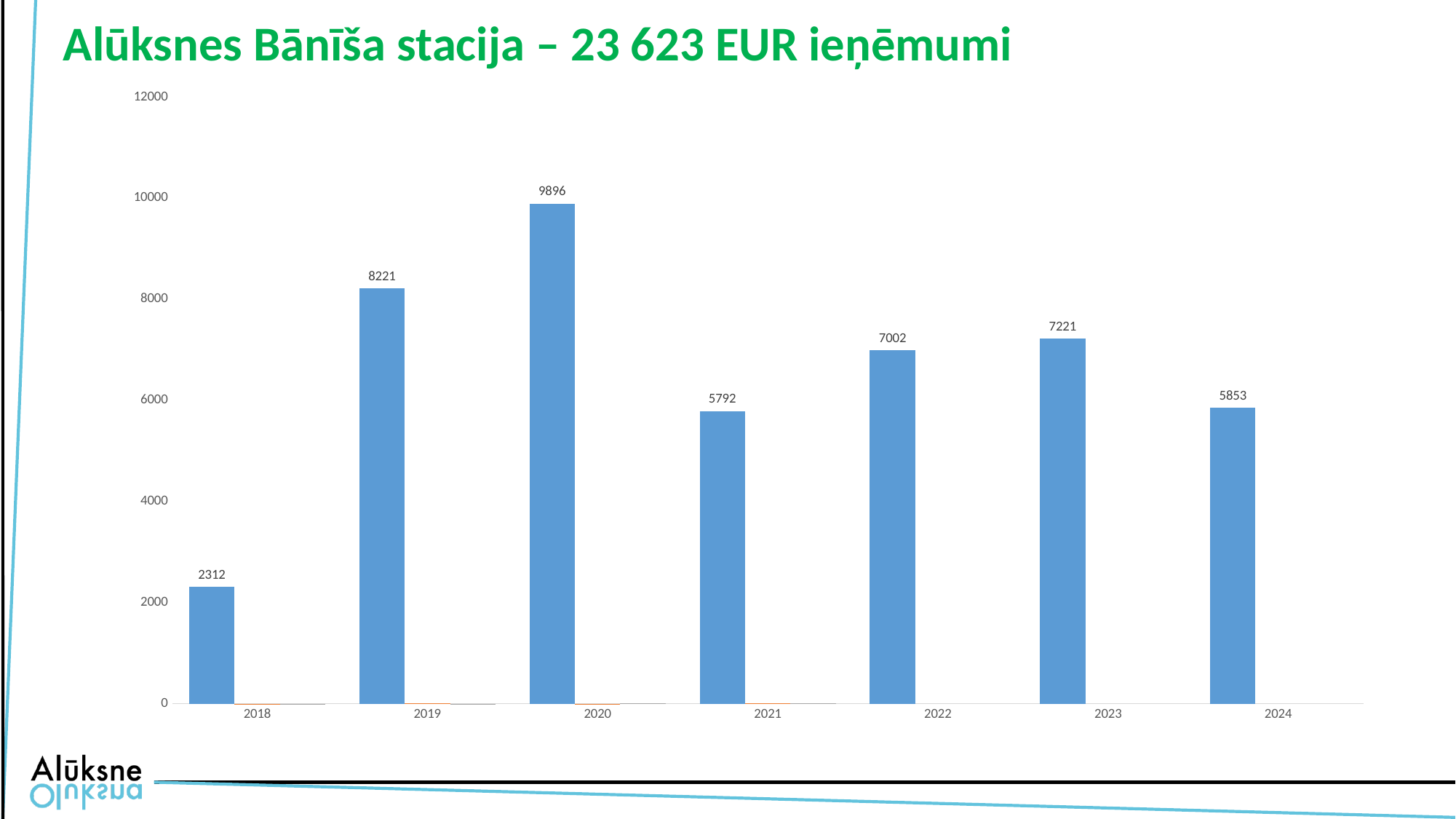
What kind of chart is shown on the slide? Bar chart What is the difference between the values for 2020 and 2019? 1675 Do the values rise or fall from 2018 to 2020? Rise What is the value for 2024? 5853 How many years are shown on the x axis? 7 What is the value for 2018? 2312 Which year has the highest value? 2020 What is the difference between the values for 2023 and 2022? 219 What is the value for 2020? 9896 Which is larger, the value for 2021 or the value for 2024? 2024 Which year has the lowest value? 2018 What is the value for 2023? 7221